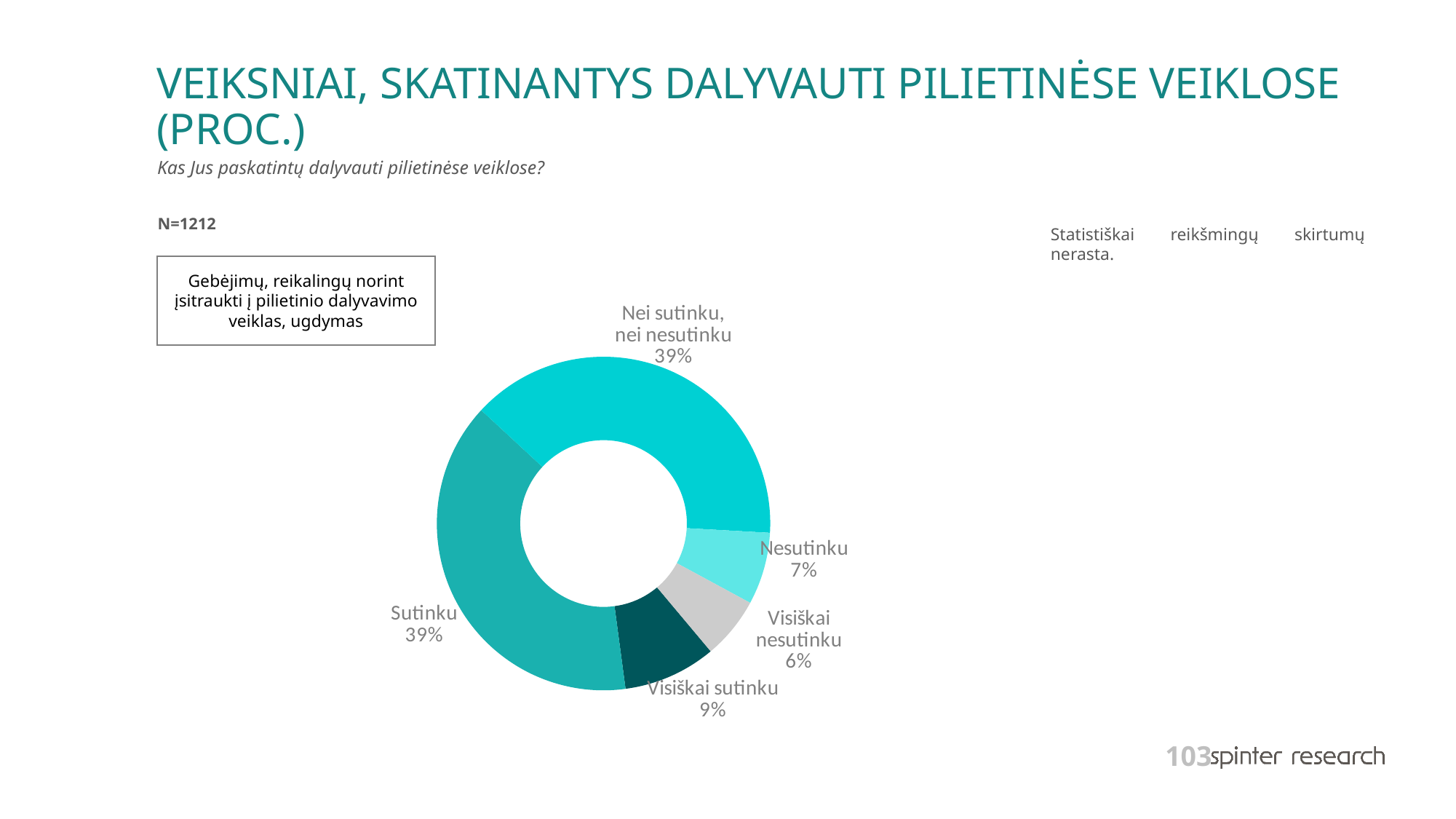
What is the difference in percentage points between "Sutinku" and "Visiškai sutinku"? 30 What percentage of respondents answered "Sutinku"? 39% How many response categories are shown in the chart? 5 What percentage of respondents answered "Nei sutinku, nei nesutinku"? 39% What is the combined share of "Sutinku" and "Visiškai sutinku"? 48% What is the sample size (N) stated on the slide? N=1212 What percentage of respondents answered "Visiškai nesutinku"? 6% What percentage of respondents answered "Visiškai sutinku"? 9% Which is larger, the share for "Nesutinku" or the share for "Visiškai sutinku"? Visiškai sutinku What percentage of respondents answered "Nesutinku"? 7% What type of chart is shown on the slide? Donut (pie) chart Which response category has the smallest share of the chart? Visiškai nesutinku